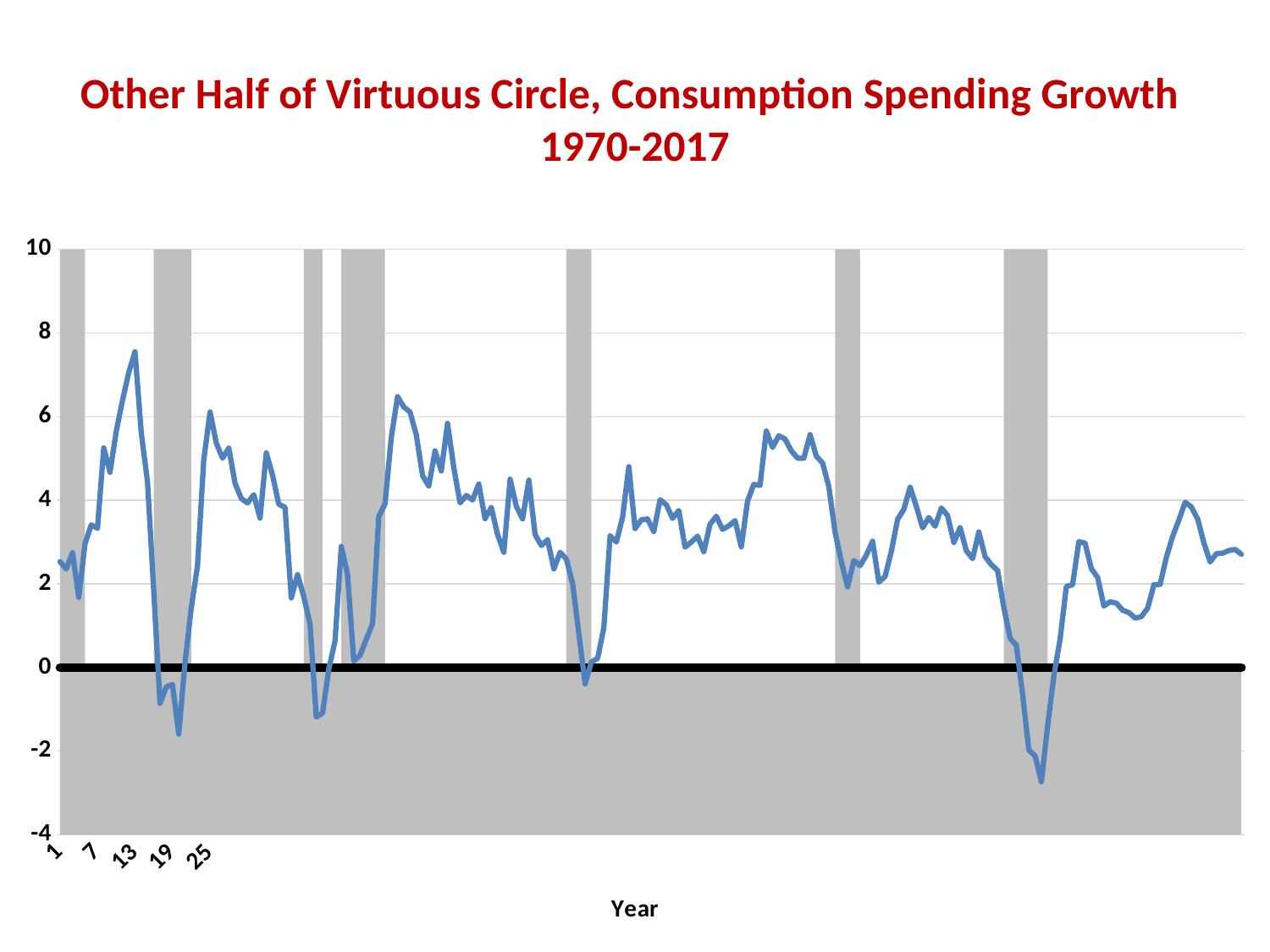
Is the lowest point of the line greater or less than -2? less What kind of chart is shown on the slide? line chart What is the title of the chart? Other Half of Virtuous Circle, Consumption Spending Growth 1970-2017 How many lines are plotted on the chart? 1 What is the label on the x axis of the chart? Year What is the highest value shown on the y axis of the chart? 10 Is the value at the first x-axis label (1) greater or less than 4? less Does the line ever fall below 0 on the chart? Yes What is the lowest value shown on the y axis of the chart? -4 How many shaded vertical bands are drawn on the chart? 7